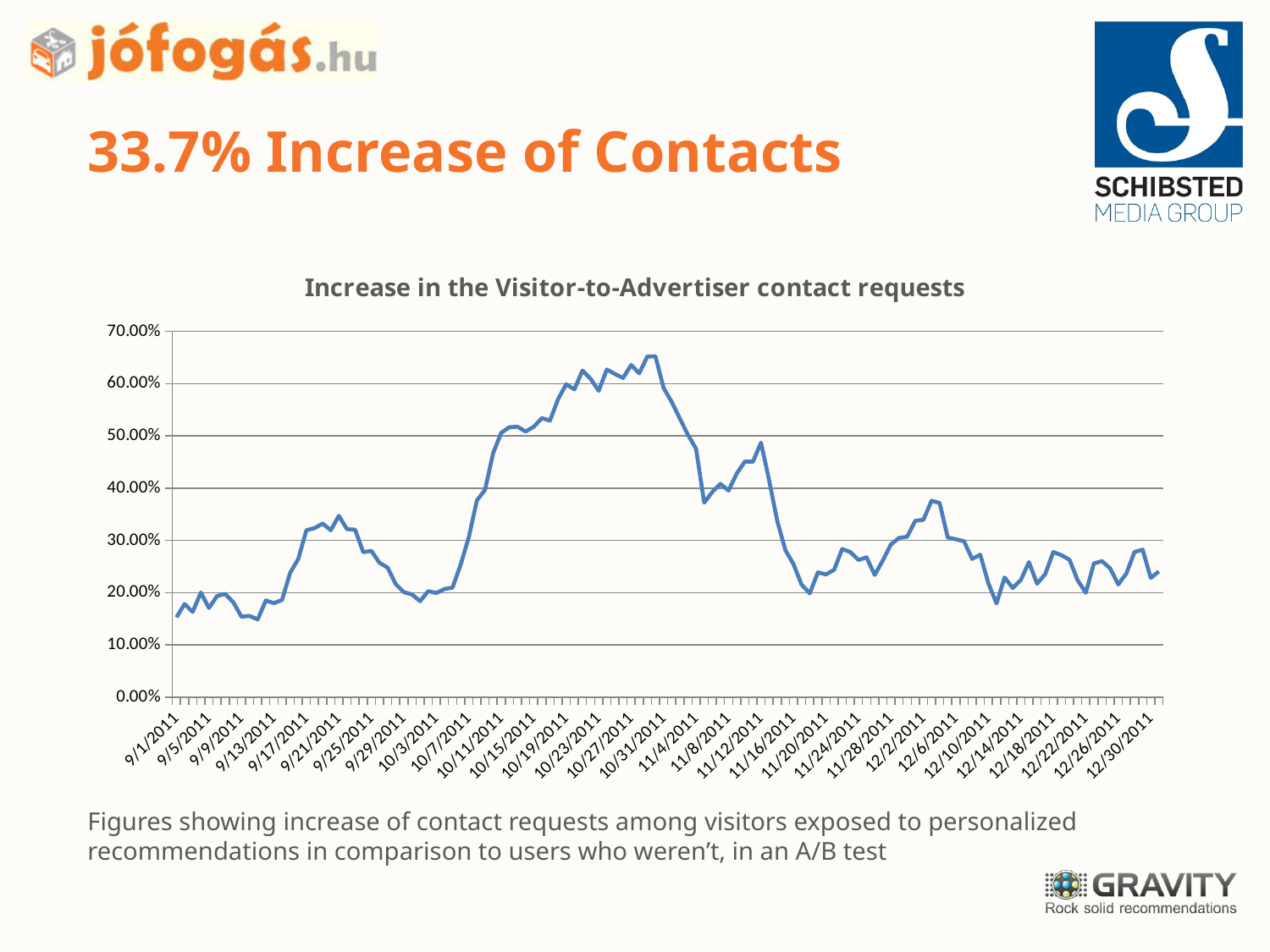
Does the line rise or fall between 10/7/2011 and 10/27/2011? rise What kind of chart is shown on the slide? line chart Is the value for 10/27/2011 greater or less than 60%? greater What is the title of the chart? Increase in the Visitor-to-Advertiser contact requests Is the value for 9/1/2011 greater or less than 20%? less Does the line rise or fall between 10/31/2011 and 11/16/2011? fall Is the value for 12/30/2011 greater or less than 30%? less What are the first and last date labels on the x axis? 9/1/2011 and 12/30/2011 Which date has the larger value, 10/23/2011 or 11/12/2011? 10/23/2011 What colour is the line plotted in the chart? blue